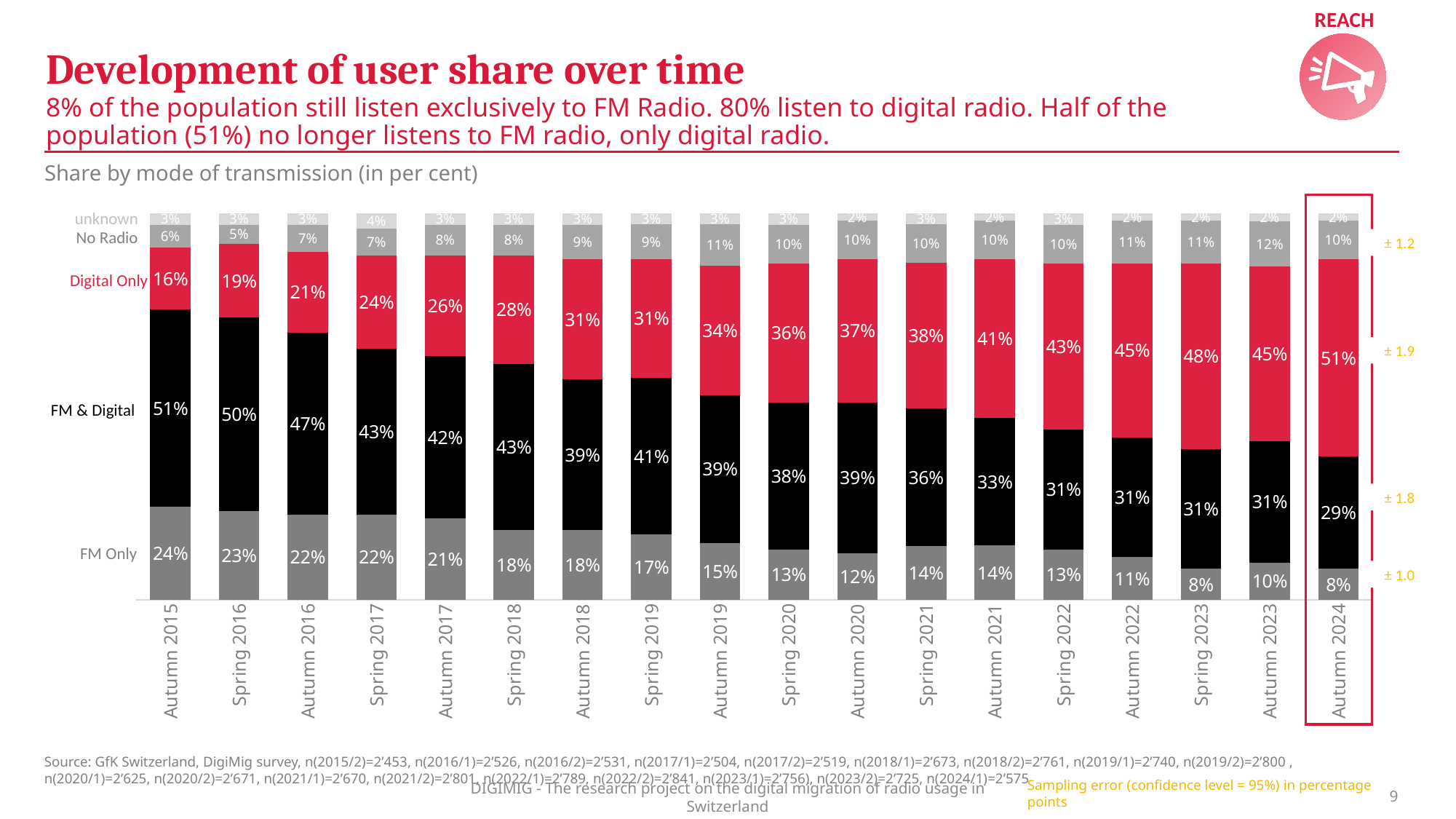
What is the Digital Only share in Autumn 2024? 51% By how many percentage points did the FM Only share fall from Autumn 2015 to Autumn 2024? 16 What is the FM Only share in Autumn 2015? 24% In which period is the Digital Only share highest? Autumn 2024 How many time periods are shown along the x axis of the chart? 18 In which period is the FM & Digital share highest? Autumn 2015 What is the FM & Digital share in Spring 2019? 41% Which is larger in Spring 2021: the Digital Only share or the FM & Digital share? Digital Only How many modes of transmission (series) are labelled on the chart? 5 What kind of chart is shown on the slide? Stacked bar chart Does the Digital Only share generally rise or fall from Autumn 2015 to Autumn 2024? Rise What is the No Radio share in Autumn 2023? 12%